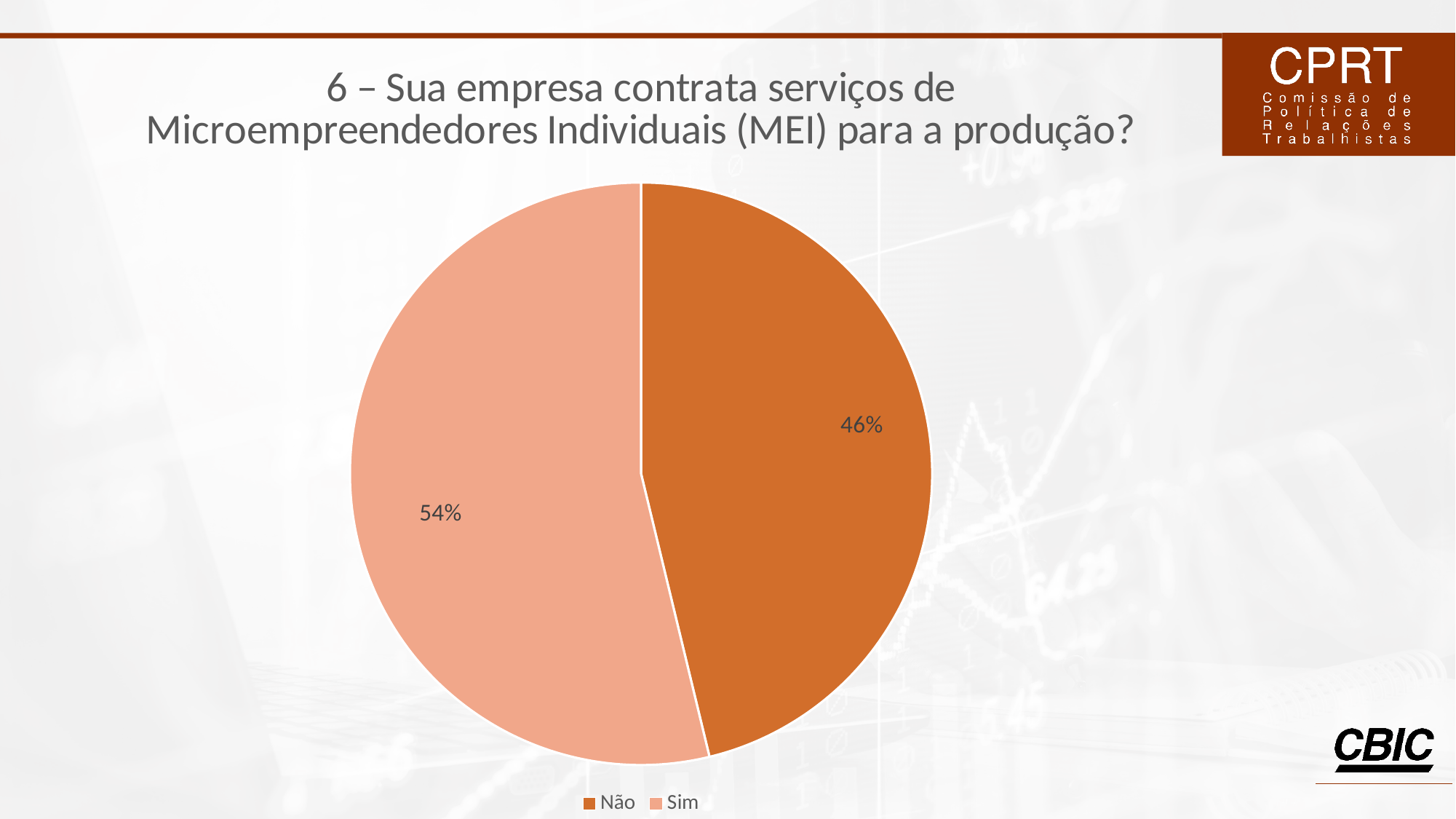
Which legend entry is shown in the darker orange colour? Não What is the difference in percentage points between the "Sim" and "Não" slices? 8 What share of the pie does "Sim" represent? 54% How many entries does the legend list? 2 Which is larger, the "Sim" slice or the "Não" slice? Sim Which category has the smallest slice of the pie? Não What is the title of the chart? 6 – Sua empresa contrata serviços de Microempreendedores Individuais (MEI) para a produção? Which category has the largest slice of the pie? Sim What share of the pie does "Não" represent? 46% What kind of chart is shown on the slide? Pie chart How many categories are shown in the pie chart? 2